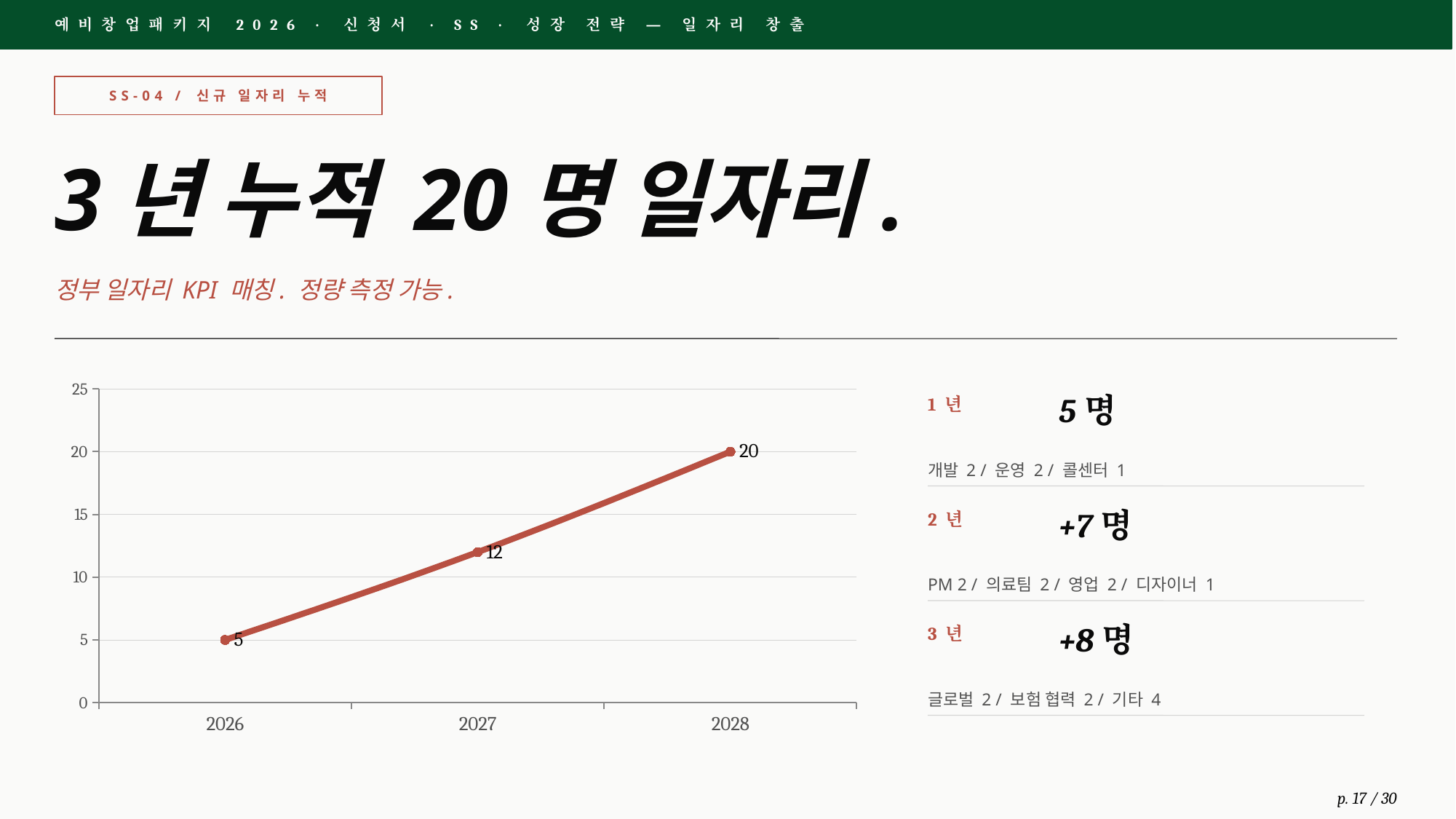
What is the value for 2026? 5 What kind of chart is shown on the slide? line chart Is the value for 2027 greater or less than 10? greater What is the value for 2027? 12 What is the difference between the values for 2027 and 2026? 7 Do the values rise or fall from 2026 to 2028? rise Which is larger, the value for 2027 or the value for 2026? 2027 What is the difference between the values for 2028 and 2027? 8 How many data points are plotted on the chart? 3 Which year has the lowest value? 2026 What is the value for 2028? 20 Which year has the highest value? 2028